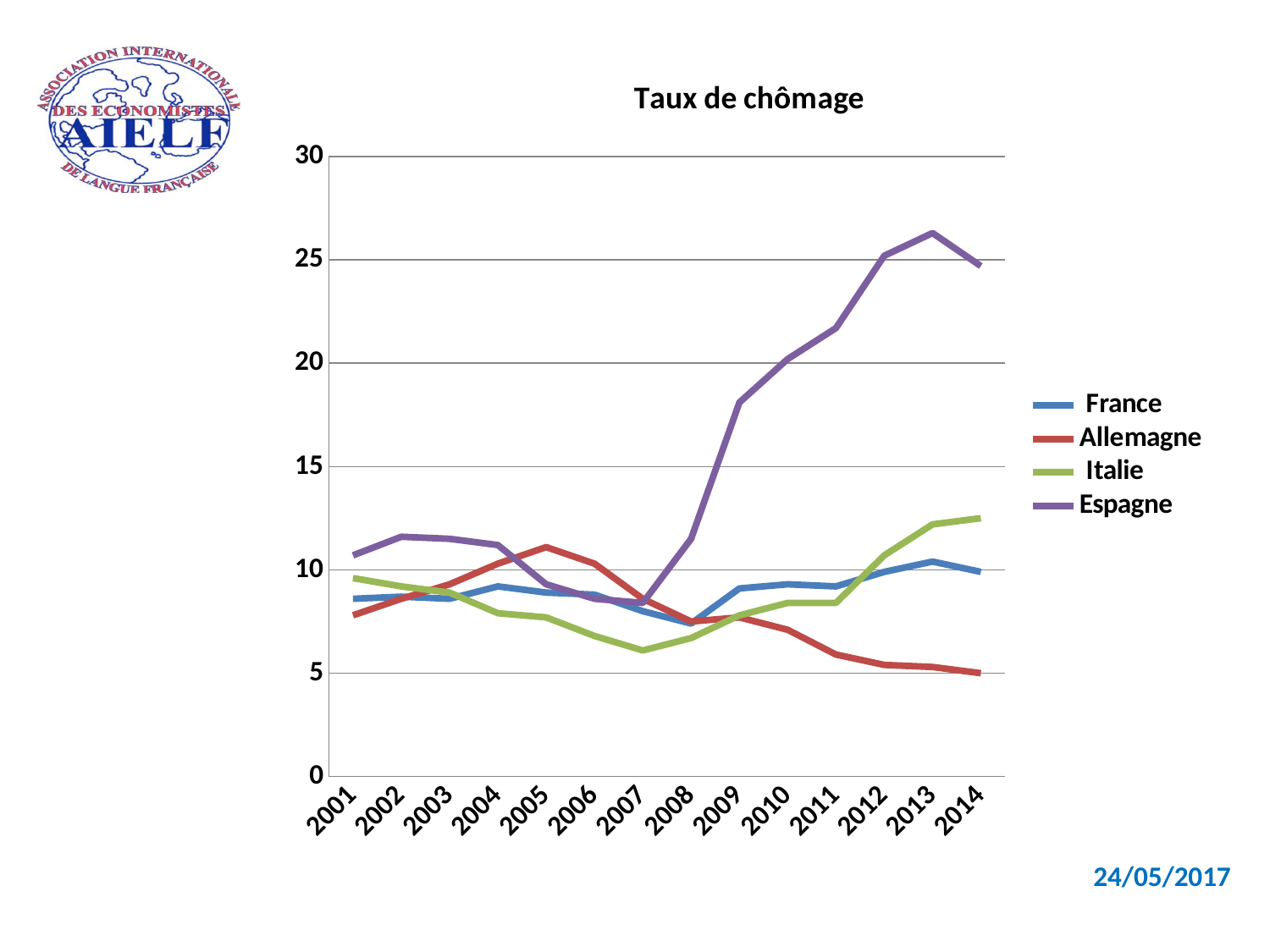
What is the title of the chart? Taux de chômage Is the value for Espagne in 2013 greater or less than 25? greater Is the value for Espagne in 2009 greater or less than 15? greater What kind of chart is shown on the slide? Line chart Is the value for Italie in 2013 greater or less than 10? greater Does the unemployment rate for Espagne rise or fall between 2008 and 2013? Rises Which country has the highest unemployment rate in 2014? Espagne In 2014, which is larger: the value for Italie or the value for France? Italie Which country has the lowest unemployment rate in 2014? Allemagne Does the unemployment rate for Allemagne rise or fall between 2005 and 2014? Falls How many years are plotted along the x axis? 14 How many series does the legend list? 4